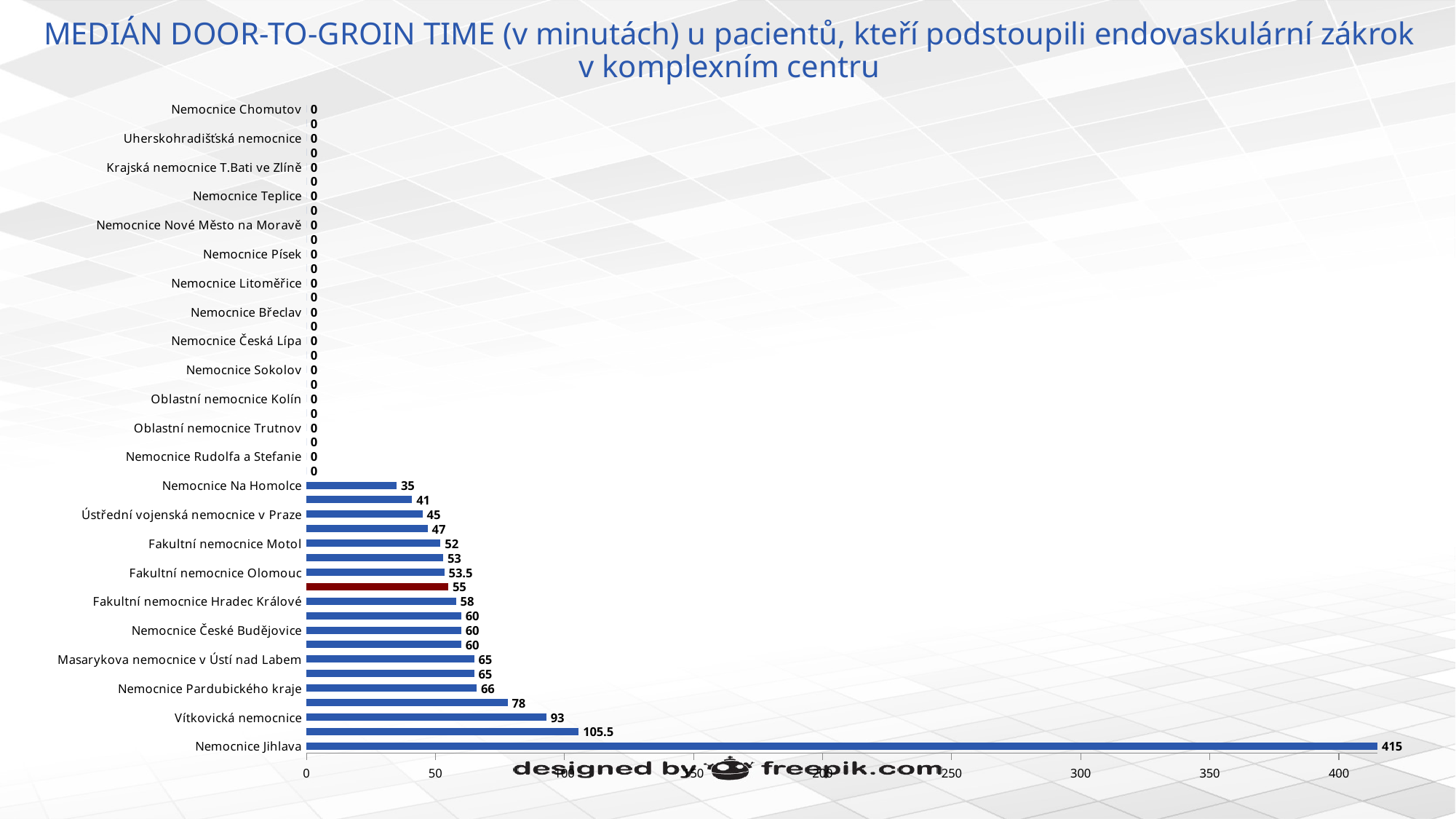
Is the value for Nemocnice Jihlava greater or less than 400? greater What is the value shown for Nemocnice Chomutov? 0 What is the median door-to-groin time for Nemocnice Jihlava? 415 What is the difference between the values for Nemocnice Jihlava and Vítkovická nemocnice? 322 What kind of chart is shown on the slide? bar chart What is the difference between the values for Nemocnice Pardubického kraje and Fakultní nemocnice Motol? 14 What value is labelled on the single red bar in the chart? 55 What is the value shown for Fakultní nemocnice Olomouc? 53.5 What is the value shown for Nemocnice Na Homolce? 35 What is the median door-to-groin time for Vítkovická nemocnice? 93 Which has a larger value, Masarykova nemocnice v Ústí nad Labem or Fakultní nemocnice Hradec Králové? Masarykova nemocnice v Ústí nad Labem Which hospital has the highest median door-to-groin time? Nemocnice Jihlava